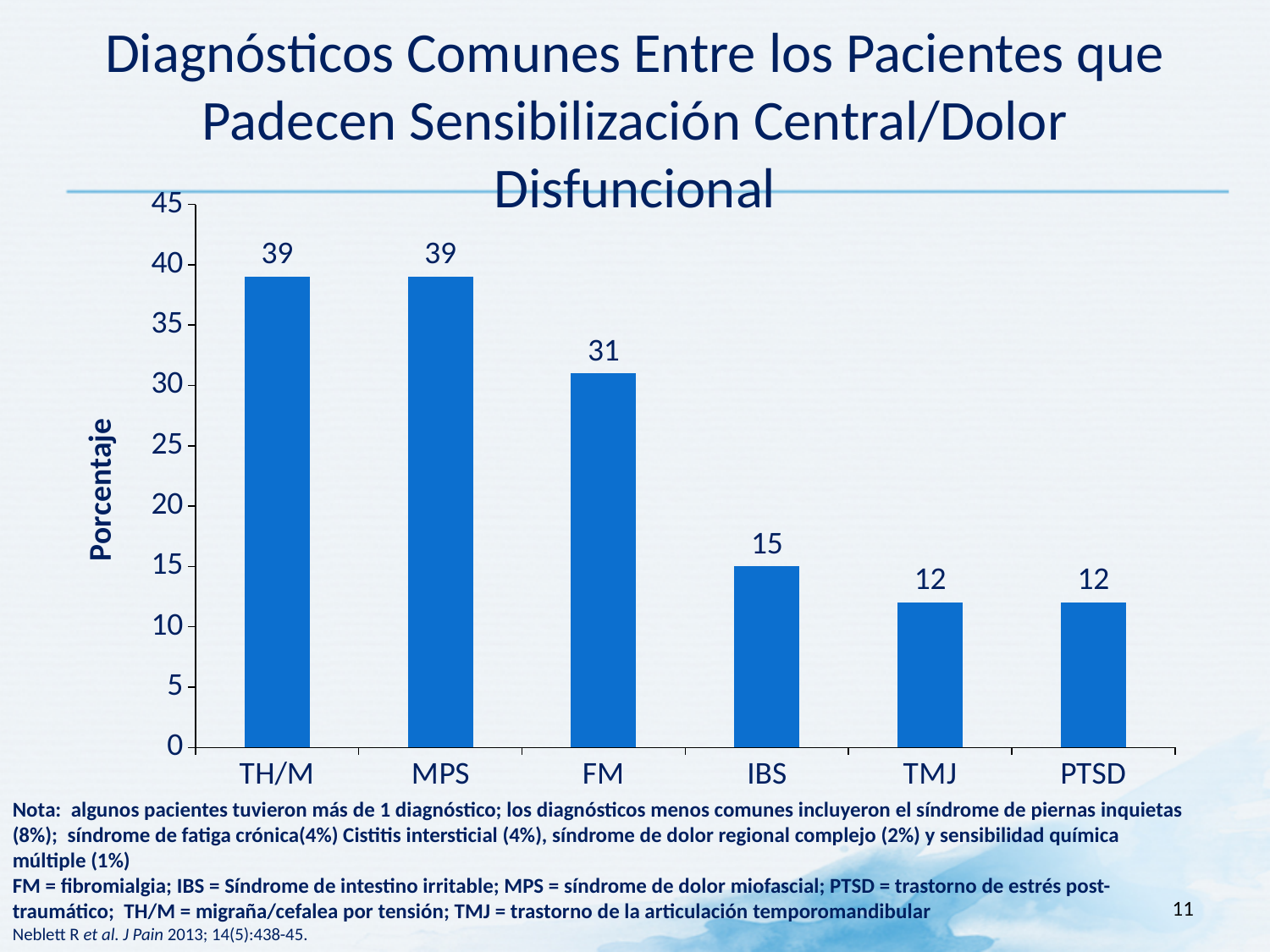
What is the label of the y axis? Porcentaje What is the difference between the values for IBS and PTSD? 3 Do the values rise or fall from left to right along the x axis? fall What is the value for IBS? 15 Which category has the lowest value, FM or IBS? IBS What is the value for MPS? 39 How many categories are shown on the x axis? 6 What is the value for TMJ? 12 What kind of chart is shown on the slide? bar chart Is the value for FM greater or less than 30? greater What is the difference between the values for TH/M and FM? 8 What is the value for FM? 31